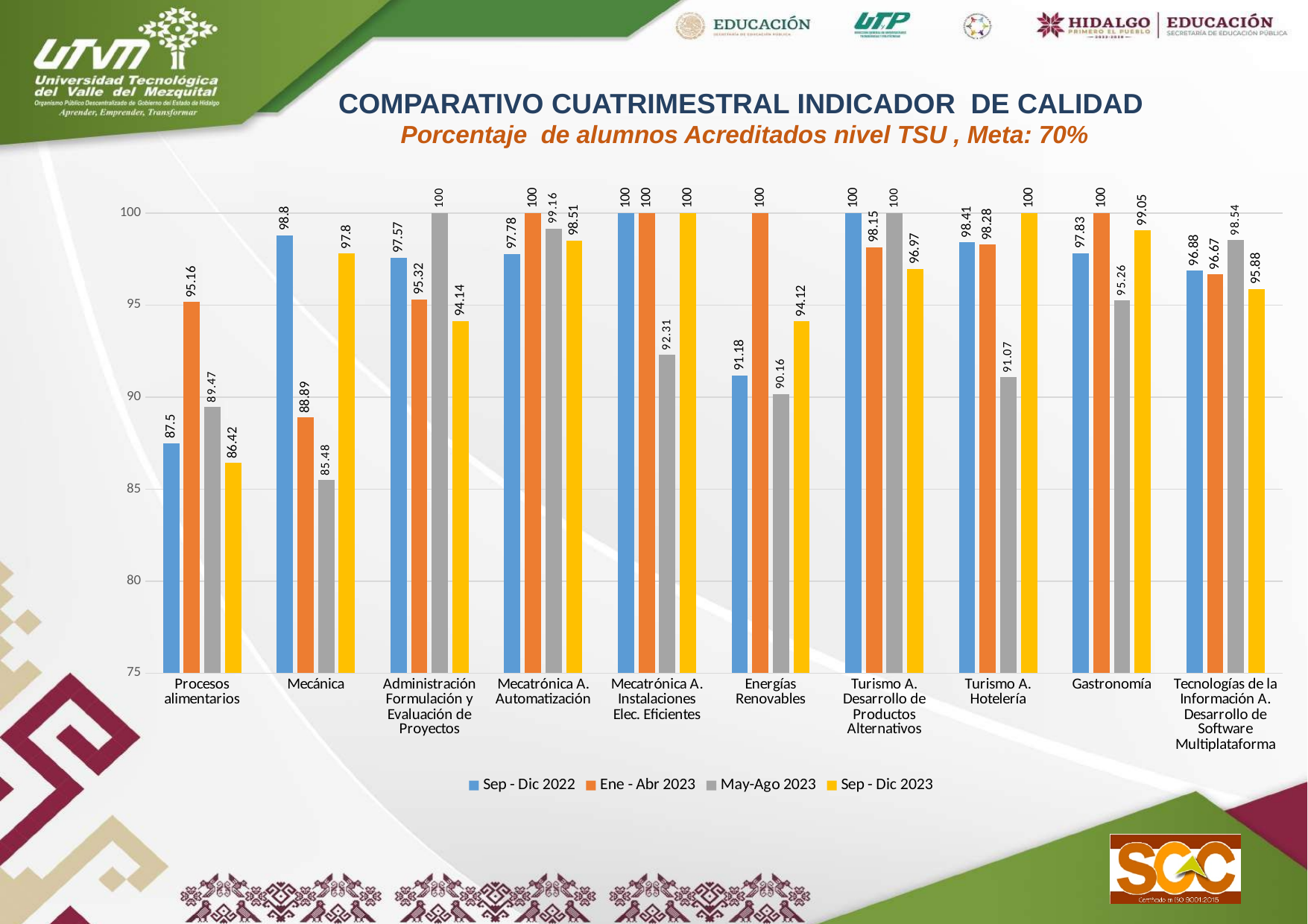
What is the value for Mecánica in the Sep - Dic 2022 series? 98.8 What kind of chart is shown on the slide? Bar chart What is the difference between the Ene - Abr 2023 and Sep - Dic 2022 values for Procesos alimentarios? 7.66 How many categories are shown on the x axis? 10 What is the target (Meta) percentage stated in the chart subtitle? 70% How many series does the legend list? 4 What is the value for Gastronomía in the Sep - Dic 2023 series? 99.05 What is the value for Energías Renovables in the May-Ago 2023 series? 90.16 Which category has the lowest value in the May-Ago 2023 series? Mecánica Which category has the lowest value in the Sep - Dic 2023 series? Procesos alimentarios Is the value for Mecánica in the Ene - Abr 2023 series greater or less than 90? less Which is larger for Turismo A. Hotelería: the Sep - Dic 2022 value or the May-Ago 2023 value? Sep - Dic 2022